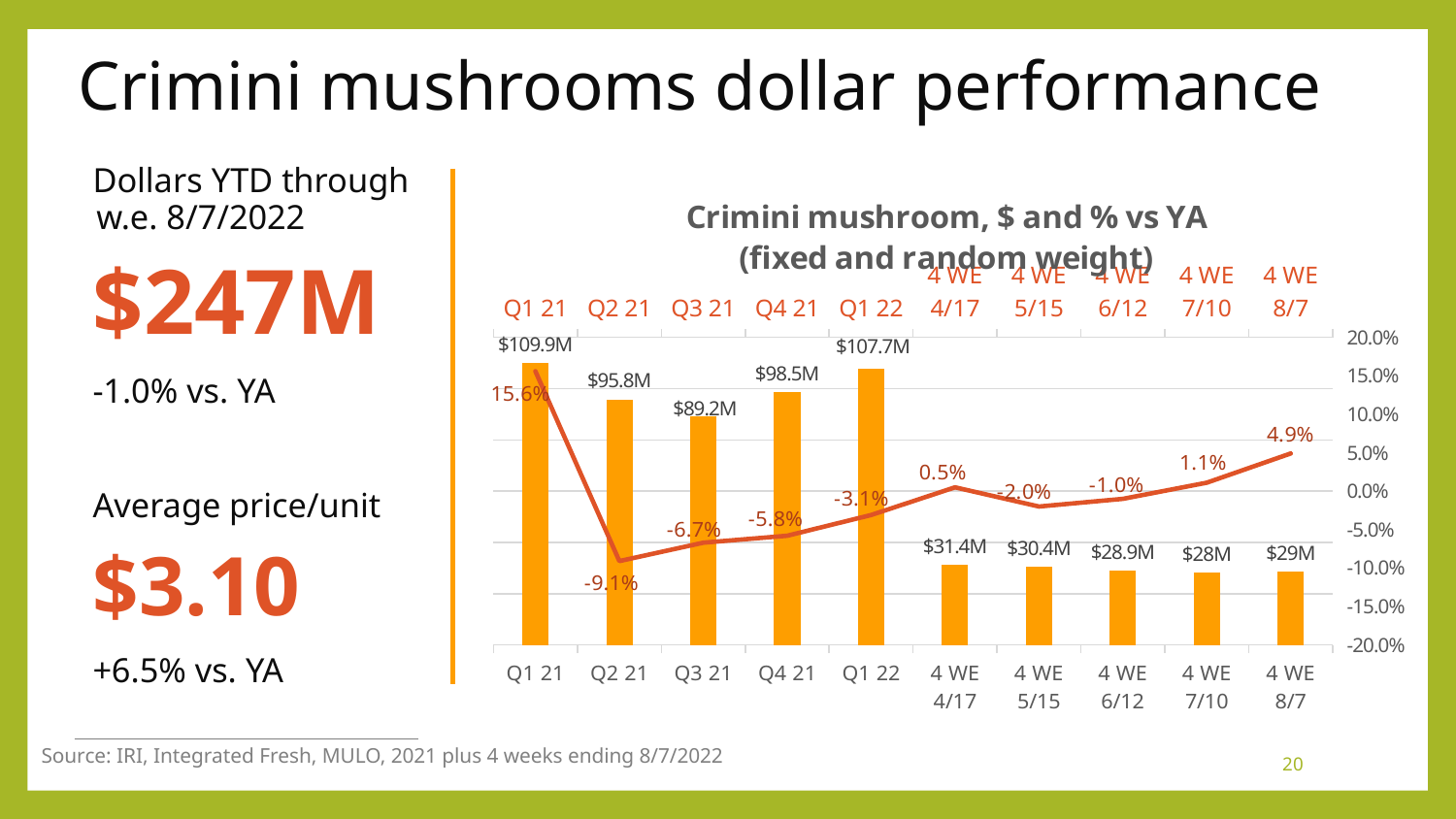
What is the title of the chart? Crimini mushroom, $ and % vs YA (fixed and random weight) What is the difference in dollars between Q1 22 and Q4 21? $9.2M Which period has the highest dollar value? Q1 21 Is the % vs YA value for Q1 21 greater or less than 10.0%? greater How many periods are shown on the x axis of the chart? 10 Does the % vs YA line rise or fall from 4 WE 5/15 to 4 WE 8/7? Rise Which has a higher dollar value, Q2 21 or Q3 21? Q2 21 What is the dollar value shown for the 4 WE 6/12 period? $28.9M What is the % vs YA value shown for the 4 WE 8/7 period? 4.9% What kind of chart is shown on the slide? Combination bar and line chart Which period has the lowest % vs YA value? Q2 21 What is the dollar value shown for Q1 21? $109.9M